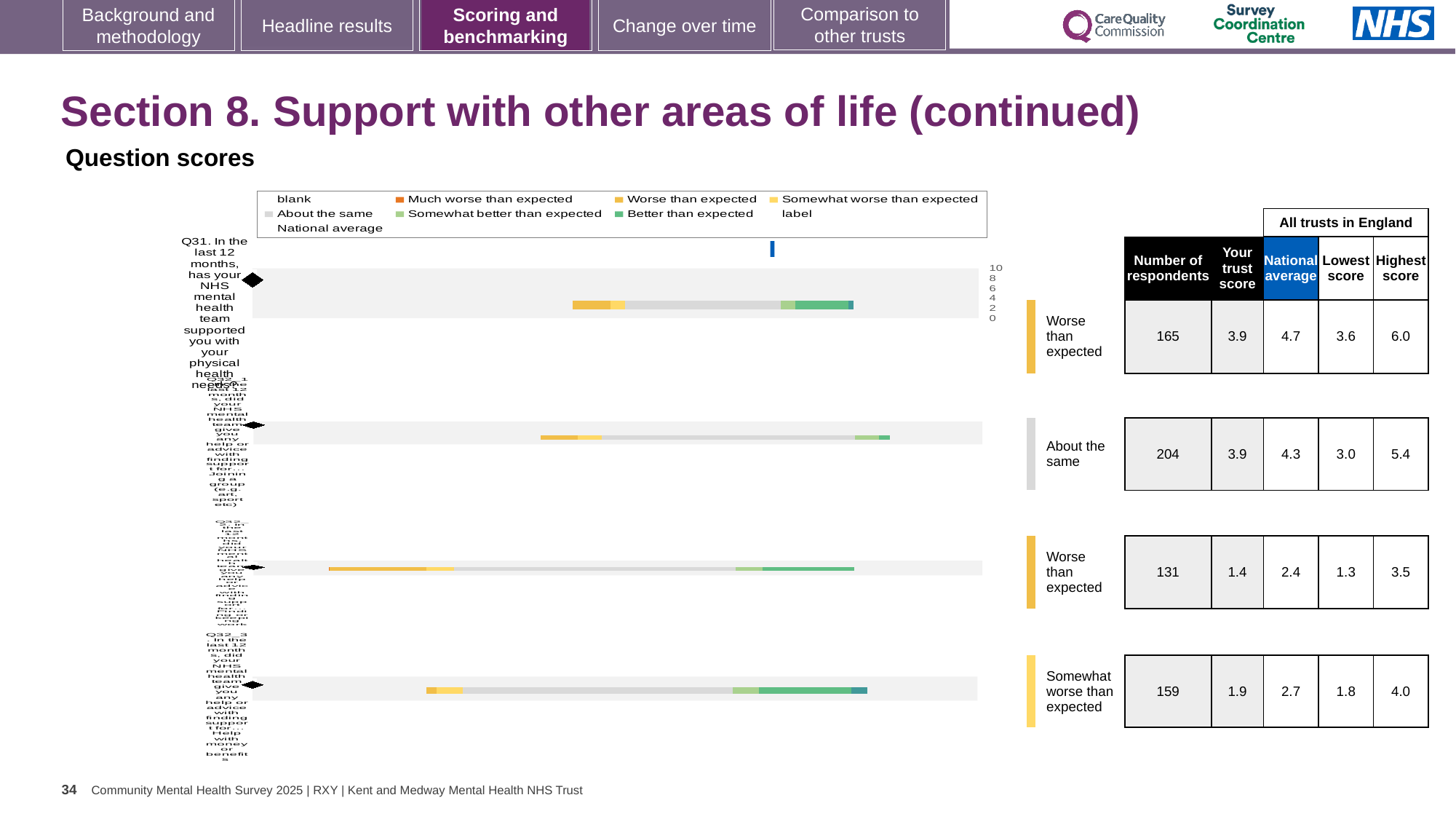
In the table beside the chart, what is the trust score for the row labelled 'About the same'? 3.9 In the table beside the chart, what is the difference between the highest score and the lowest score for the first row (Q31)? 2.4 In the table beside the chart, which row has the lowest trust score? the third row (Worse than expected, 1.4) How many entries does the chart legend list? 9 In the table beside the chart, is the trust score for the 'About the same' row larger or smaller than its national average? smaller How many question bars are plotted in the chart? 4 What is the highest tick value shown on the chart's axis? 10 In the table beside the chart, which row has the highest number of respondents? About the same Which legend entry is shown in orange? Much worse than expected In the table beside the chart, what is the national average for the row labelled 'Somewhat worse than expected'? 2.7 In the table beside the chart, what is the number of respondents for the first row (Q31, Worse than expected)? 165 What kind of chart is shown on the slide? bar chart